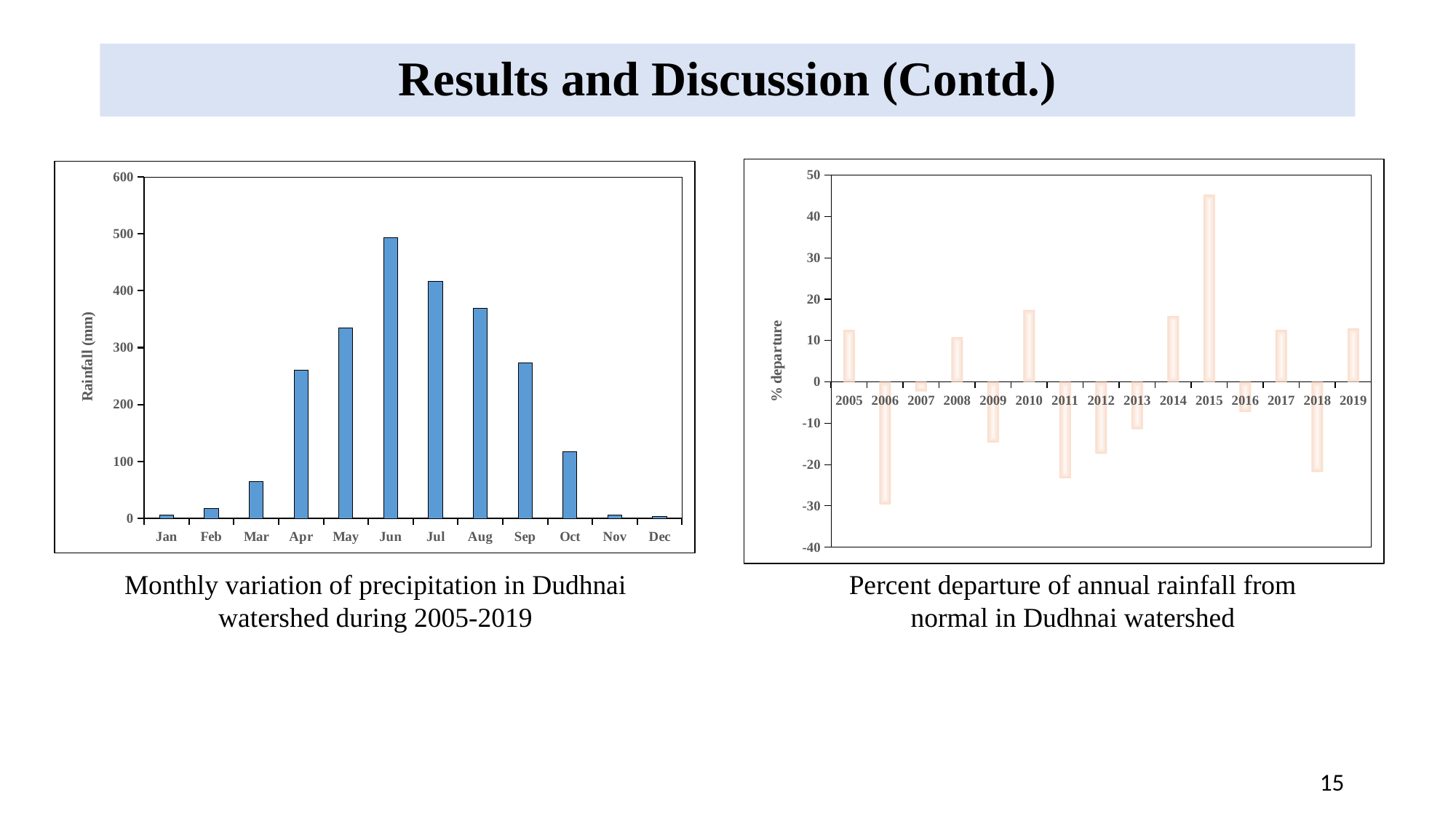
In the chart titled 'Monthly variation of precipitation in Dudhnai watershed during 2005-2019', what is the label of the y axis? Rainfall (mm) In the chart titled 'Percent departure of annual rainfall from normal in Dudhnai watershed', how many years are plotted on the x axis? 15 In the chart titled 'Monthly variation of precipitation in Dudhnai watershed during 2005-2019', is the rainfall for Mar greater or less than 100? less In the chart titled 'Monthly variation of precipitation in Dudhnai watershed during 2005-2019', is the rainfall for Jun greater or less than 400? greater In the chart titled 'Monthly variation of precipitation in Dudhnai watershed during 2005-2019', which month has the highest rainfall? Jun In the chart titled 'Monthly variation of precipitation in Dudhnai watershed during 2005-2019', what kind of chart is shown? Bar chart In the chart titled 'Monthly variation of precipitation in Dudhnai watershed during 2005-2019', how many months are plotted on the x axis? 12 In the chart titled 'Percent departure of annual rainfall from normal in Dudhnai watershed', which year has the lowest percent departure? 2006 In the chart titled 'Percent departure of annual rainfall from normal in Dudhnai watershed', which year has the highest percent departure? 2015 In the chart titled 'Monthly variation of precipitation in Dudhnai watershed during 2005-2019', do the values rise or fall from Jan to Jun? Rise In the chart titled 'Monthly variation of precipitation in Dudhnai watershed during 2005-2019', which month has higher rainfall, Jul or Aug? Jul In the chart titled 'Percent departure of annual rainfall from normal in Dudhnai watershed', is the value for 2006 greater or less than -20? less